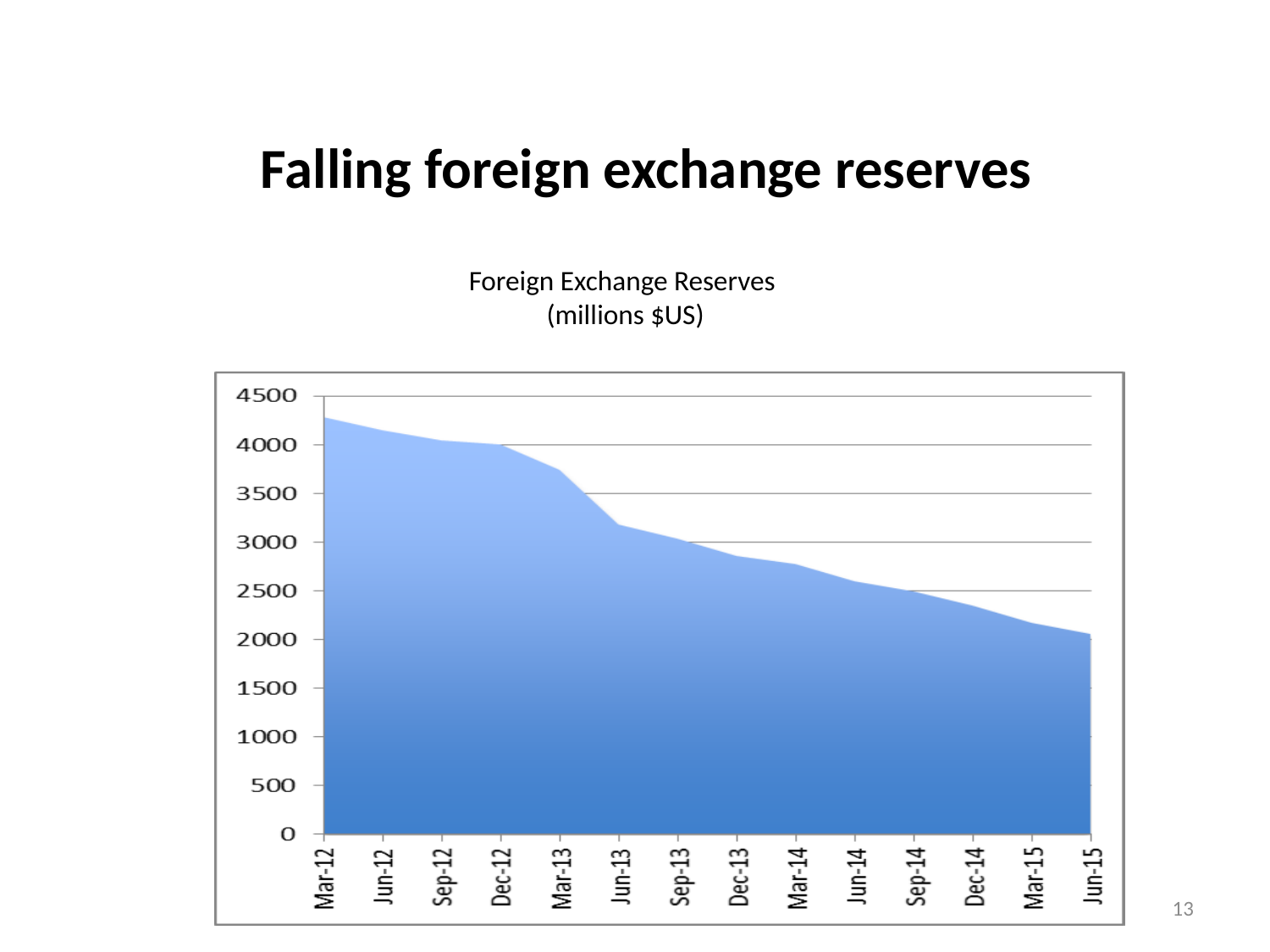
Is the value for Mar-15 greater or less than 2500? less Is the value for Mar-12 greater or less than 4000? greater How many time points are labelled on the x axis of the chart? 14 Is the value for Jun-13 greater or less than 3500? less At which date are foreign exchange reserves lowest? Jun-15 Do foreign exchange reserves rise or fall from Mar-12 to Jun-15? Fall At which date are foreign exchange reserves highest? Mar-12 What is the title of the chart? Foreign Exchange Reserves (millions $US) Which is larger, the value for Sep-12 or the value for Sep-14? Sep-12 What kind of chart is shown on the slide? Area chart